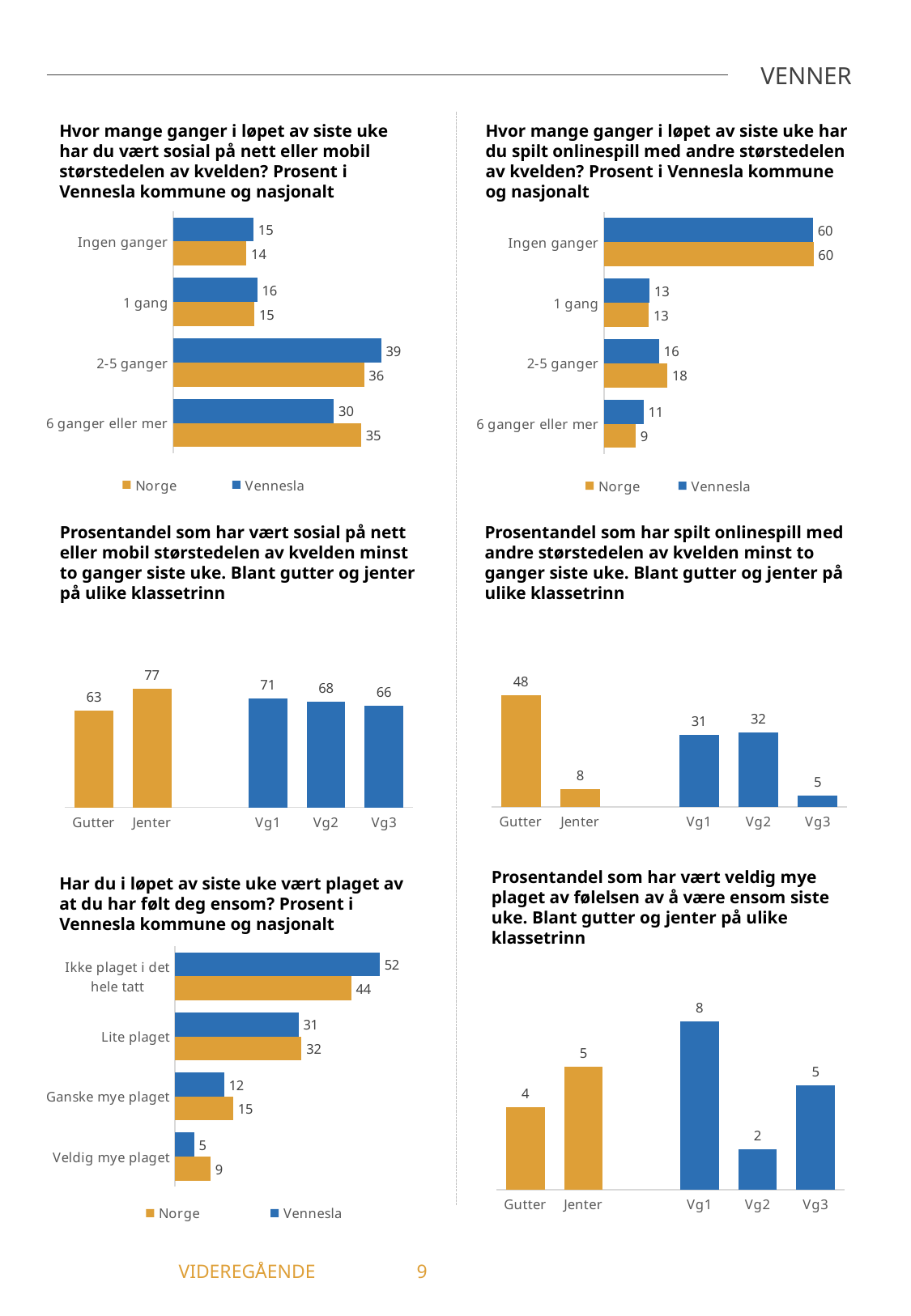
In the bottom-left chart (plaget av å ha følt deg ensom), which is larger for 'Ikke plaget i det hele tatt': Norge or Vennesla? Vennesla What kind of chart is the bottom-right chart (veldig mye plaget av følelsen av å være ensom)? Bar chart In the top-right chart (spilt onlinespill), which category has the lowest value for Norge? 6 ganger eller mer In the top-right chart (spilt onlinespill), what is the value for Norge in the 'Ingen ganger' category? 60 In the middle-right chart (spilt onlinespill, gutter og jenter på ulike klassetrinn), how many categories are shown? 5 In the bottom-left chart (plaget av å ha følt deg ensom), what is the value for Norge in the 'Veldig mye plaget' category? 9 In the top-left chart (sosial på nett eller mobil), what is the difference between Norge and Vennesla for '6 ganger eller mer'? 5 In the middle-left chart (sosial på nett, gutter og jenter på ulike klassetrinn), what is the value for Vg2? 68 In the middle-right chart (spilt onlinespill, gutter og jenter på ulike klassetrinn), what is the difference between Gutter and Jenter? 40 In the top-left chart (sosial på nett eller mobil), what is the value for Vennesla in the '2-5 ganger' category? 39 In the top-right chart (spilt onlinespill), how many series does the legend list? 2 In the middle-left chart (sosial på nett, gutter og jenter på ulike klassetrinn), which category has the highest value? Jenter